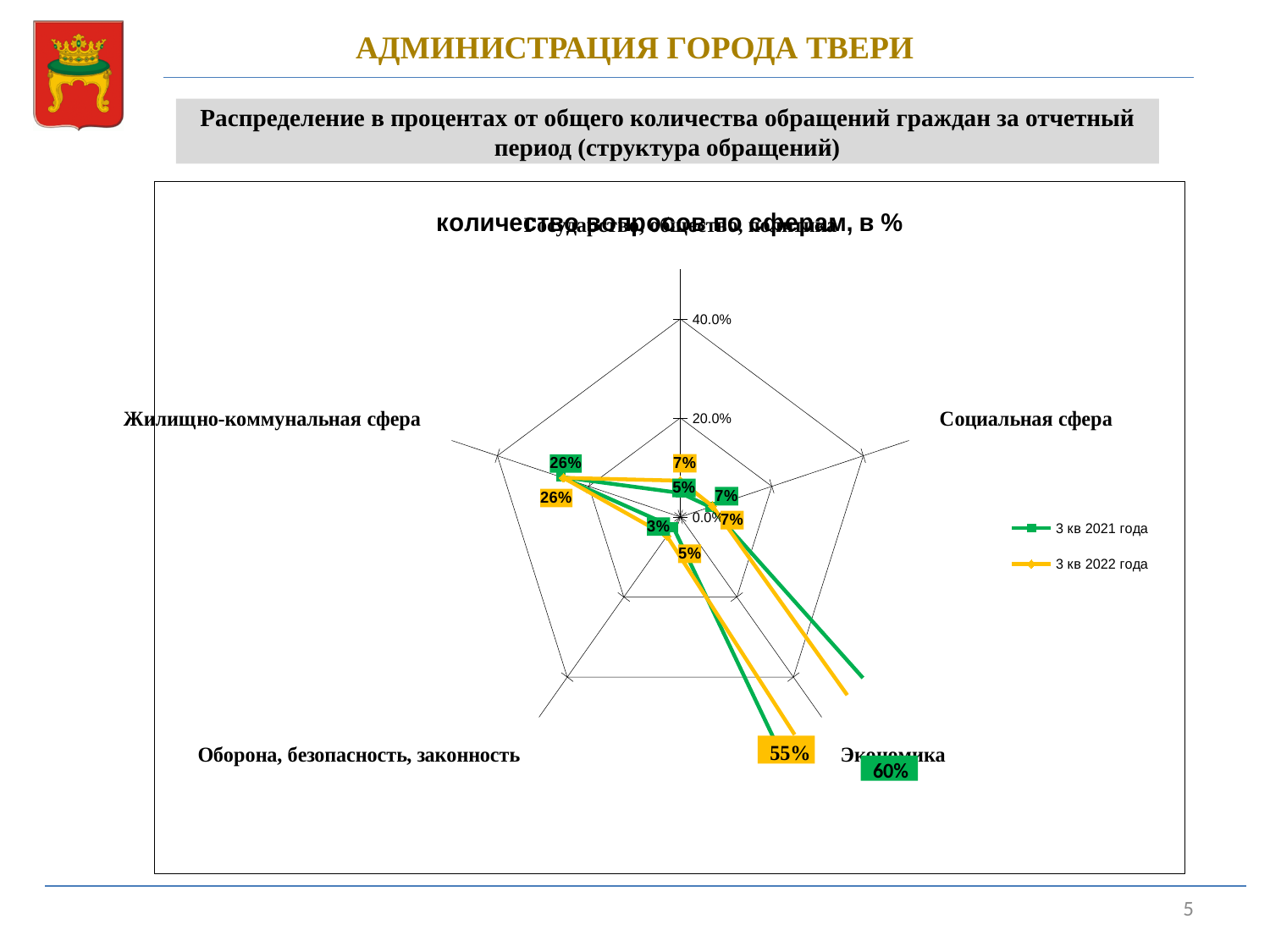
Which category has the lowest value in the series 3 кв 2021 года? Оборона, безопасность, законность What is the title of the chart? количество вопросов по сферам, в % What is the value for Экономика in the series 3 кв 2022 года? 55% How many series does the legend list? 2 What is the value for Жилищно-коммунальная сфера in the series 3 кв 2022 года? 26% What is the difference between the Экономика values for 3 кв 2021 года and 3 кв 2022 года? 5% Which series has the larger value for Экономика, 3 кв 2021 года or 3 кв 2022 года? 3 кв 2021 года What is the value for Социальная сфера in the series 3 кв 2021 года? 7% What kind of chart is shown on the slide? Radar chart What is the value for Экономика in the series 3 кв 2021 года? 60% Which category has the highest value in the series 3 кв 2021 года? Экономика How many categories (axes) does the radar chart have? 5